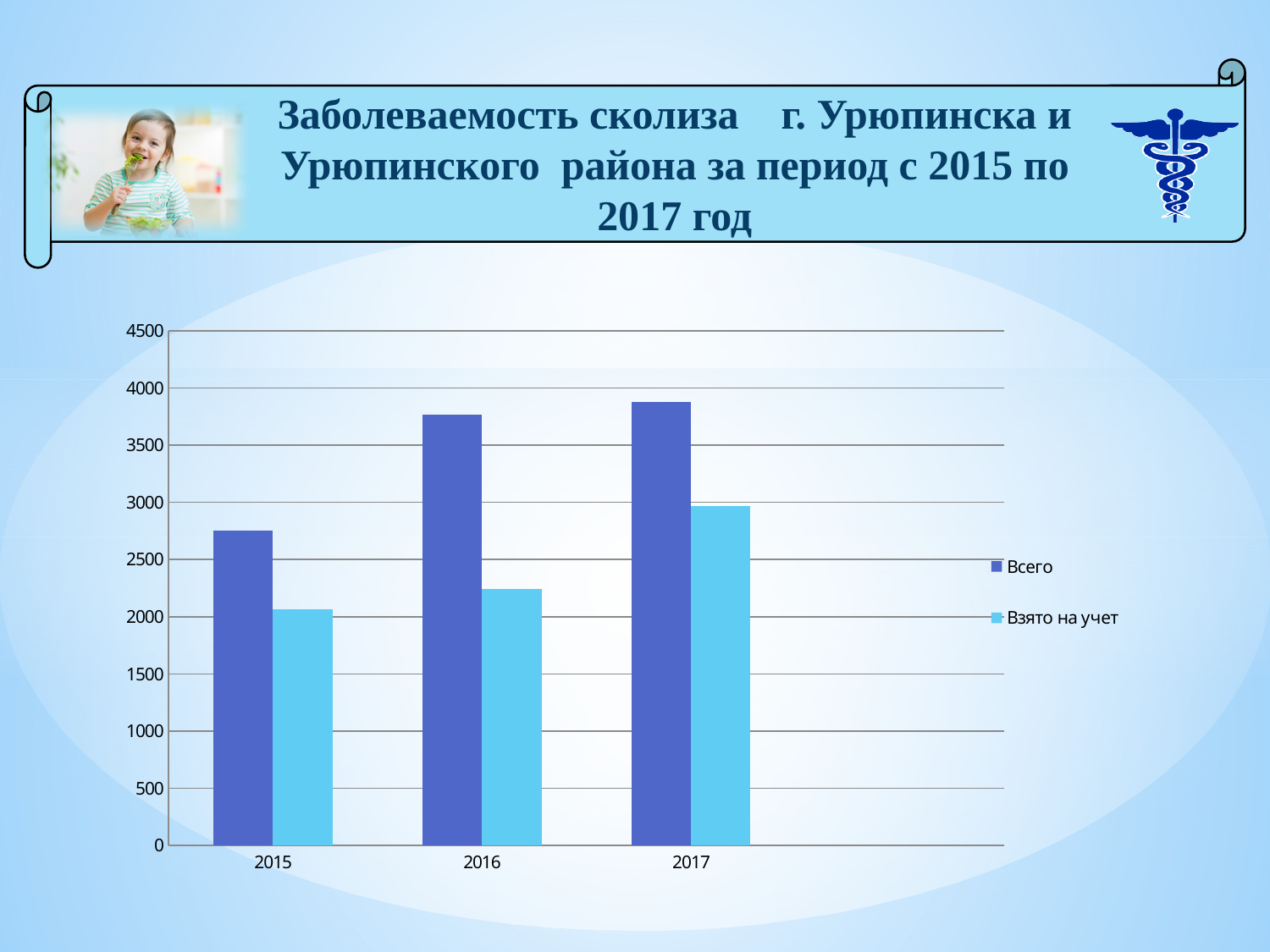
In which year is the value for Взято на учет the highest? 2017 Do the values for Всего rise or fall from 2015 to 2017? rise How many years are shown on the x axis of the chart? 3 How many series does the chart legend list? 2 Is the value for Всего in 2015 greater or less than 2500? greater In which year is the value for Взято на учет the lowest? 2015 What kind of chart is shown on the slide? bar chart Is the value for Всего in 2016 greater or less than 3500? greater What are the two series named in the chart legend? Всего, Взято на учет In which year is the value for Всего the lowest? 2015 Is the value for Взято на учет in 2015 greater or less than 2500? less Which is larger in 2017: the value for Всего or the value for Взято на учет? Всего